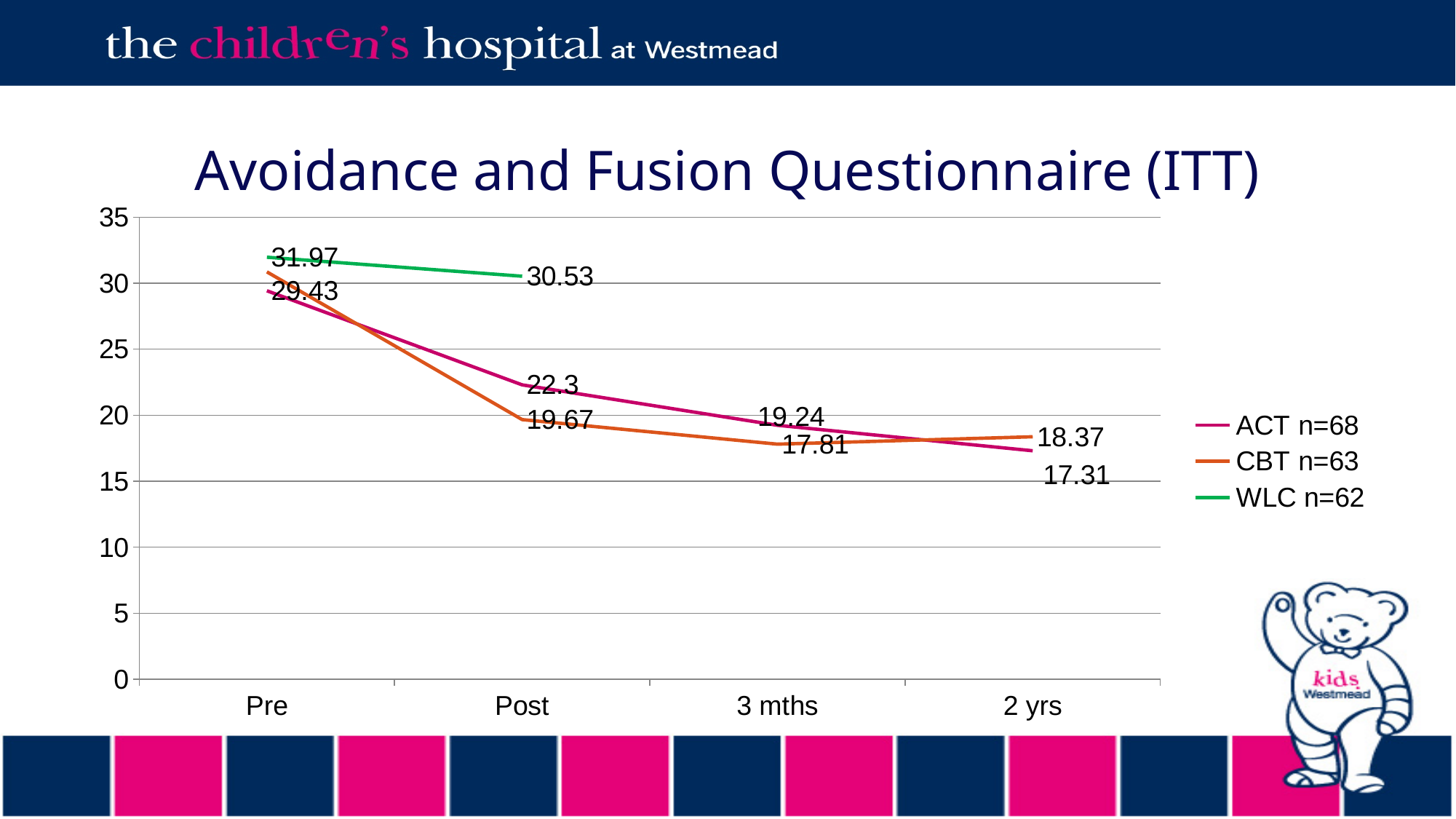
Is the value for CBT n=63 at Pre greater or less than 25? greater What is the difference between the ACT n=68 value at Pre and at 2 yrs? 12.12 What is the value for WLC n=62 at Post? 30.53 What is the value for ACT n=68 at 2 yrs? 17.31 How many series does the legend list? 3 Does the ACT n=68 line rise or fall from Pre to 2 yrs? fall What is the difference between the WLC n=62 value at Pre and at Post? 1.44 What is the value for CBT n=63 at 3 mths? 17.81 What kind of chart is shown on the slide? line chart How many time points are shown on the x axis? 4 At 2 yrs, which series has the larger value, ACT n=68 or CBT n=63? CBT n=63 What is the value for ACT n=68 at Post? 22.3